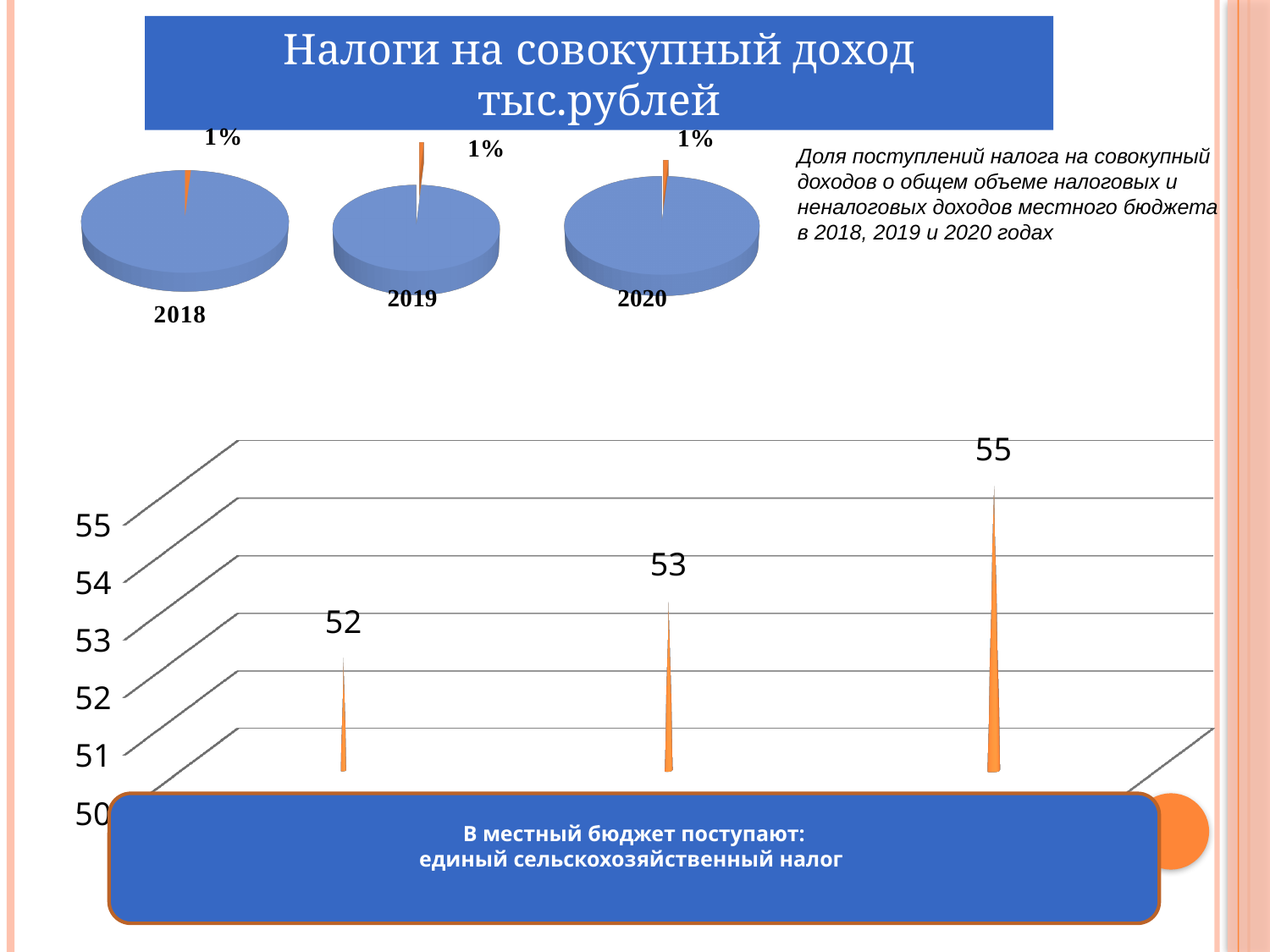
On the bottom chart, what is the value of the middle bar? 53 On the bottom chart, which bar has the highest value: the left, middle or right one? right How many bars are plotted on the bottom chart? 3 What kind of chart is the bottom chart? bar chart On the bottom chart, what is the value of the leftmost bar? 52 In the pie chart labelled 2019, what share is shown for the orange slice? 1% On the bottom chart, which bar has the lowest value: the left, middle or right one? left On the bottom chart, what is the difference between the rightmost bar and the leftmost bar? 3 On the bottom chart, what is the difference between the middle bar and the leftmost bar? 1 On the bottom chart, what is the value of the rightmost bar? 55 On the bottom chart, do the values rise or fall from left to right? rise How many pie charts are shown at the top of the slide? 3